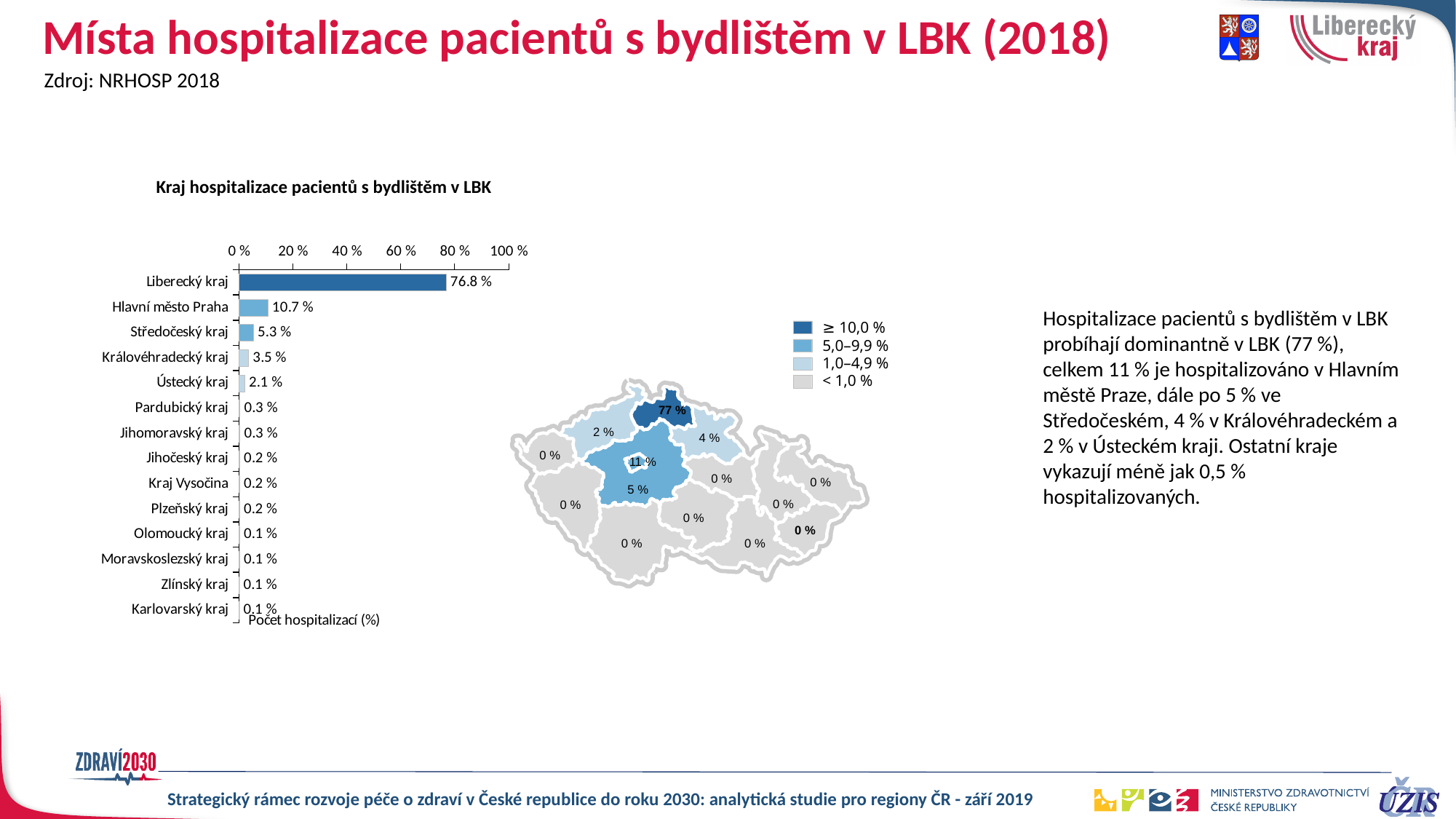
What is the value for Liberecký kraj in the bar chart? 76.8 % What is the value for Hlavní město Praha in the bar chart? 10.7 % What is the title of the bar chart? Kraj hospitalizace pacientů s bydlištěm v LBK What is the difference between the values for Hlavní město Praha and Středočeský kraj in the bar chart? 5.4 % What kind of chart is used to show the regions of hospitalization? bar chart What is the value for Královéhradecký kraj in the bar chart? 3.5 % What is the difference between the values for Liberecký kraj and Hlavní město Praha in the bar chart? 66.1 % In the bar chart, which is larger: the value for Středočeský kraj or the value for Královéhradecký kraj? Středočeský kraj Which region has the highest value in the bar chart? Liberecký kraj Is the value for Liberecký kraj in the bar chart greater or less than 60 %? greater How many regions are listed in the bar chart? 14 What is the value for Ústecký kraj in the bar chart? 2.1 %